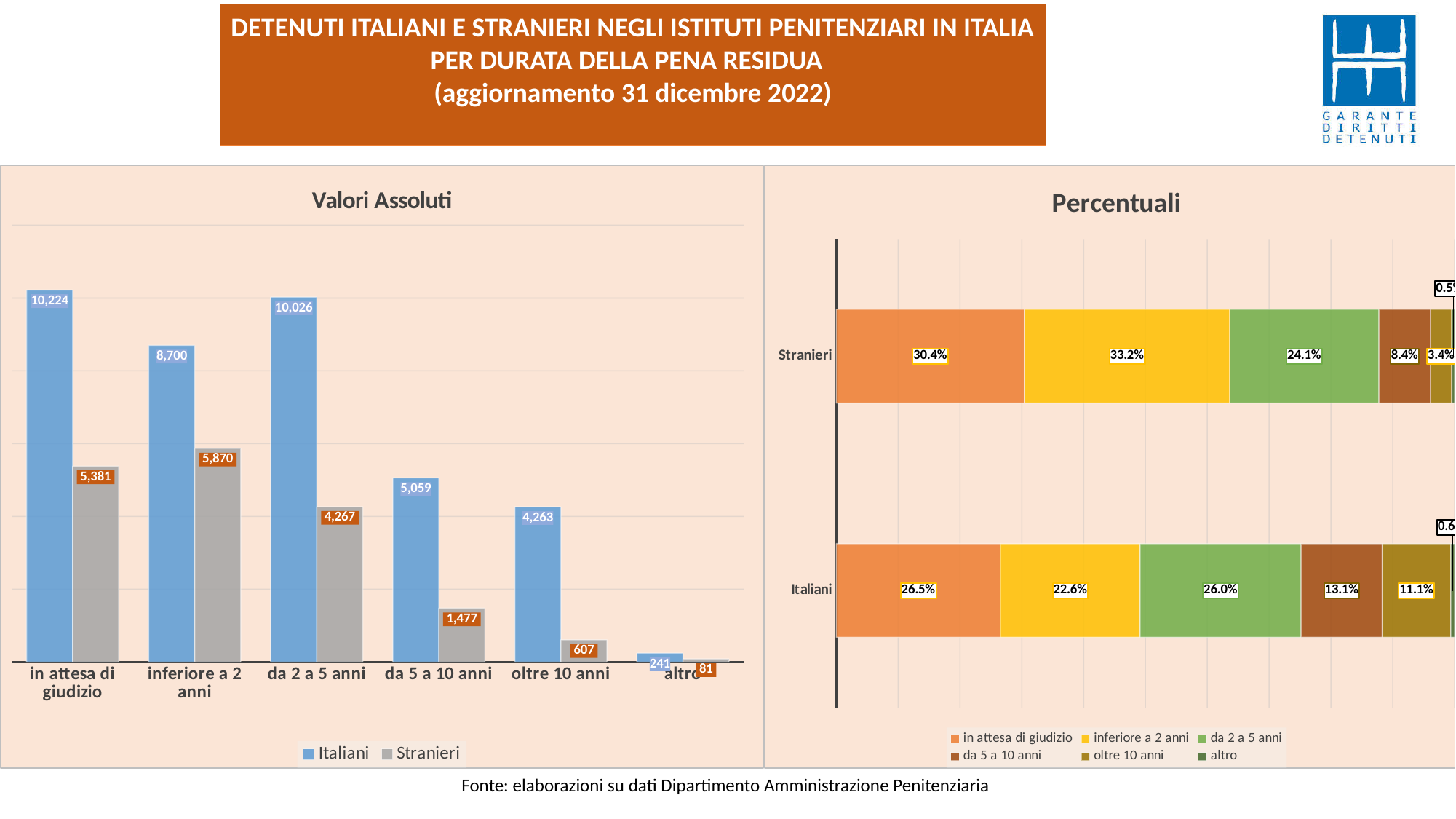
In the 'Percentuali' chart, what is the share of 'oltre 10 anni' for Italiani? 11.1% In the 'Valori Assoluti' chart, what is the value for Italiani in the 'in attesa di giudizio' category? 10,224 In the 'Valori Assoluti' chart, which is larger: Italiani in 'in attesa di giudizio' or Italiani in 'da 2 a 5 anni'? in attesa di giudizio In the 'Percentuali' chart, what is the share of 'inferiore a 2 anni' for Stranieri? 33.2% How many series does the legend of the 'Valori Assoluti' chart list? 2 In the 'Valori Assoluti' chart, what is the value for Stranieri in the 'inferiore a 2 anni' category? 5,870 How many categories are shown on the x axis of the 'Valori Assoluti' chart? 6 In the 'Valori Assoluti' chart, what is the difference between Italiani and Stranieri in the 'da 5 a 10 anni' category? 3,582 In the 'Valori Assoluti' chart, which category has the highest value for Stranieri? inferiore a 2 anni What kind of chart is the 'Valori Assoluti' chart? bar chart How many series does the legend of the 'Percentuali' chart list? 6 In the 'Valori Assoluti' chart, which category has the lowest value for Italiani? altro